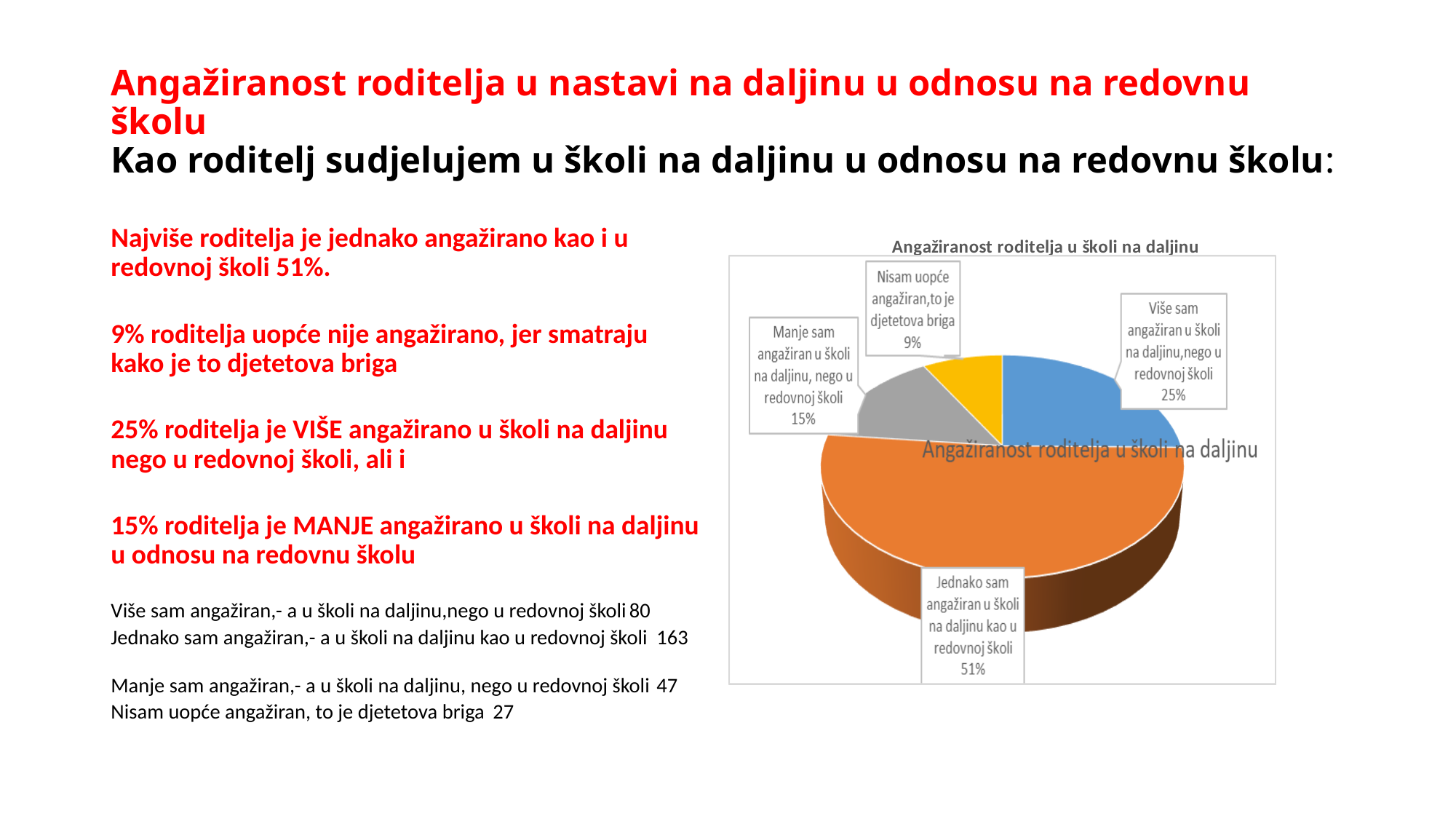
How many slices does the pie chart have? 4 What share of the pie is labelled "Nisam uopće angažiran, to je djetetova briga"? 9% What is the difference in percentage points between the "Jednako sam angažiran" slice and the "Više sam angažiran" slice? 26 Which slice of the pie chart is the largest? Jednako sam angažiran u školi na daljinu kao u redovnoj školi Which slice of the pie chart is the smallest? Nisam uopće angažiran, to je djetetova briga What is the title of the chart? Angažiranost roditelja u školi na daljinu What kind of chart is shown on the slide? pie chart What share of the pie is labelled "Više sam angažiran u školi na daljinu, nego u redovnoj školi"? 25% What share of the pie is labelled "Jednako sam angažiran u školi na daljinu kao u redovnoj školi"? 51% Which slice is larger: "Manje sam angažiran u školi na daljinu" or "Nisam uopće angažiran"? Manje sam angažiran u školi na daljinu, nego u redovnoj školi What colour is the slice labelled 51% in the pie chart? orange